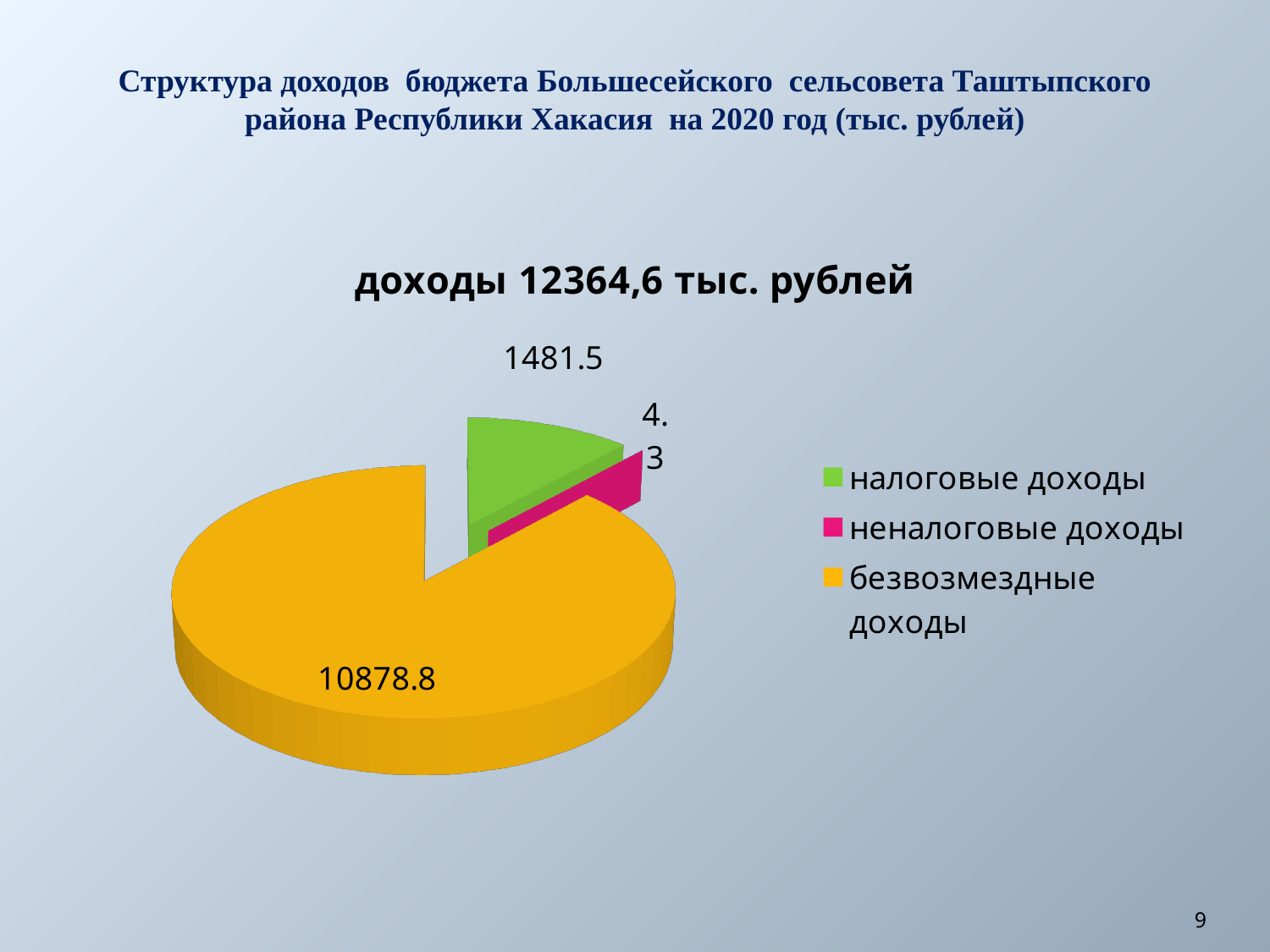
What kind of chart is shown on the slide? pie chart What share of the pie does безвозмездные доходы represent, to the nearest percent? 88% What is the value for неналоговые доходы? 4.3 Which category has the smallest slice of the pie? неналоговые доходы What is the difference between налоговые доходы and неналоговые доходы? 1477.2 What is the value for налоговые доходы? 1481.5 What is the title of the chart? доходы 12364,6 тыс. рублей Which category has the largest slice of the pie? безвозмездные доходы What is the value for безвозмездные доходы? 10878.8 What is the difference between безвозмездные доходы and налоговые доходы? 9397.3 Which is larger, налоговые доходы or неналоговые доходы? налоговые доходы How many categories does the pie chart have? 3